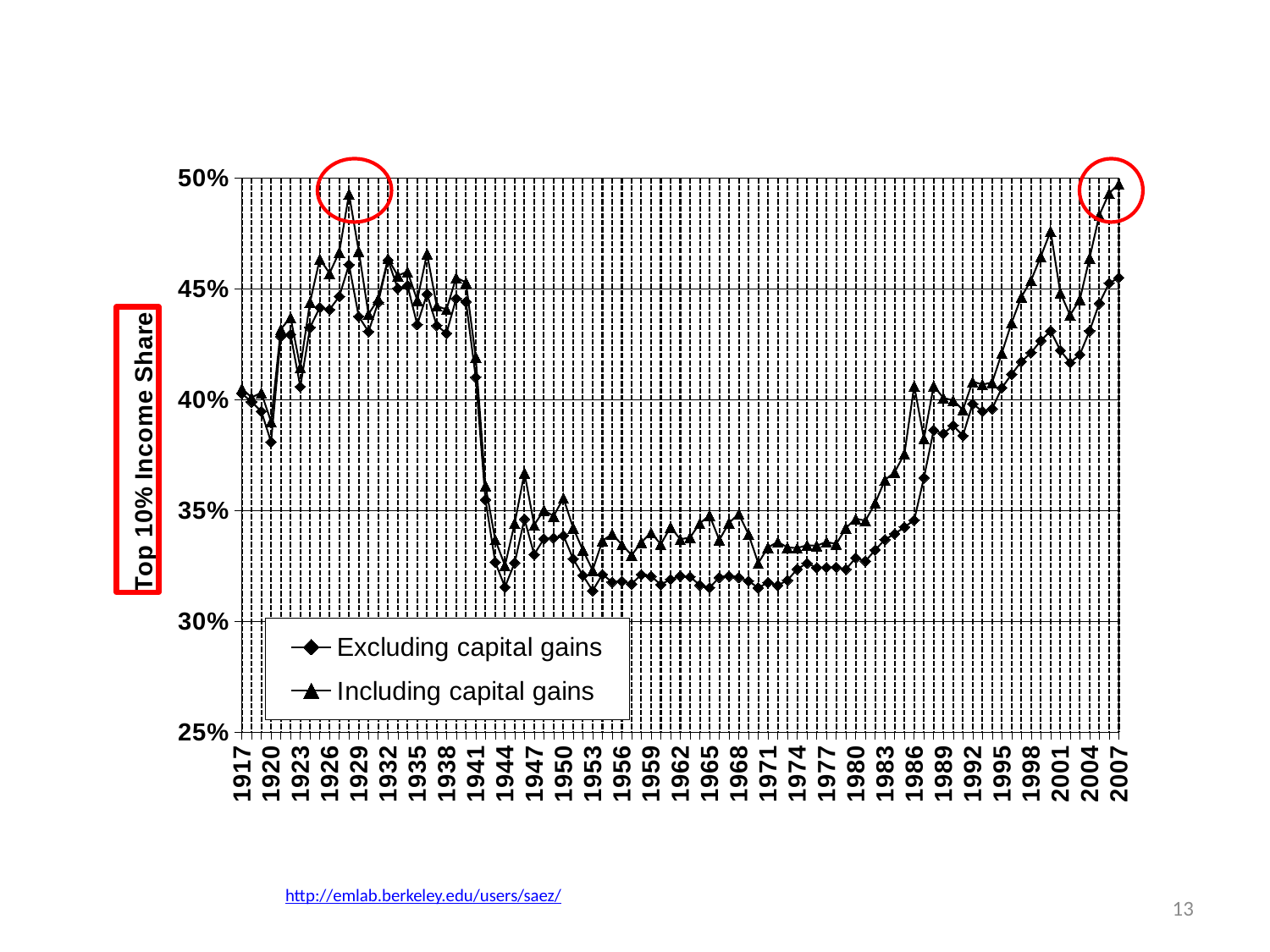
What is the title of the vertical axis? Top 10% Income Share Is the value for Excluding capital gains in 1944 greater or less than 35%? less Is the value for Excluding capital gains in 1971 greater or less than 35%? less In 1986, which series has the higher value, Excluding capital gains or Including capital gains? Including capital gains What are the two series named in the legend? Excluding capital gains; Including capital gains Is the value for Including capital gains in 2007 greater or less than 45%? greater What kind of chart is shown on the slide? line chart How many series does the legend list? 2 Between 1941 and 1944, does the Including capital gains series rise or fall? fall Between 1983 and 2007, does the Excluding capital gains series generally rise or fall? rise